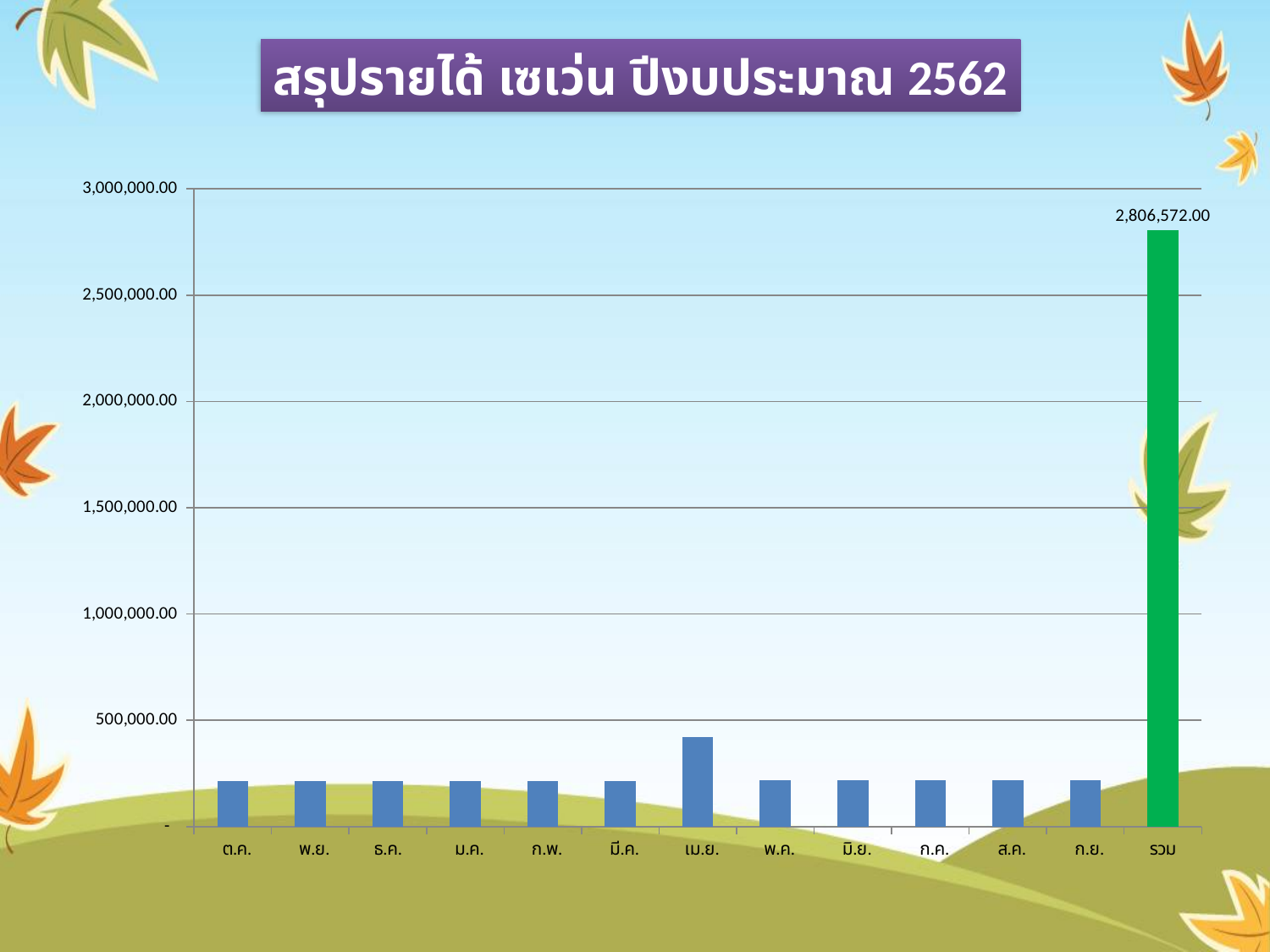
Which is larger, the value for เม.ย. or the value for พ.ค.? เม.ย. Is the value for ต.ค. greater or less than 500,000.00? less Which category has the highest value? รวม What is the title of the slide? สรุปรายได้ เซเว่น ปีงบประมาณ 2562 What is the value for รวม? 2,806,572.00 Among the monthly bars (excluding รวม), which month has the highest value? เม.ย. What kind of chart is shown on the slide? bar chart Is the value for รวม greater or less than 2,500,000.00? greater Which is larger, the value for รวม or the value for เม.ย.? รวม How many categories are shown on the x axis? 13 Is the value for เม.ย. greater or less than 500,000.00? less What colour is the bar for รวม? green